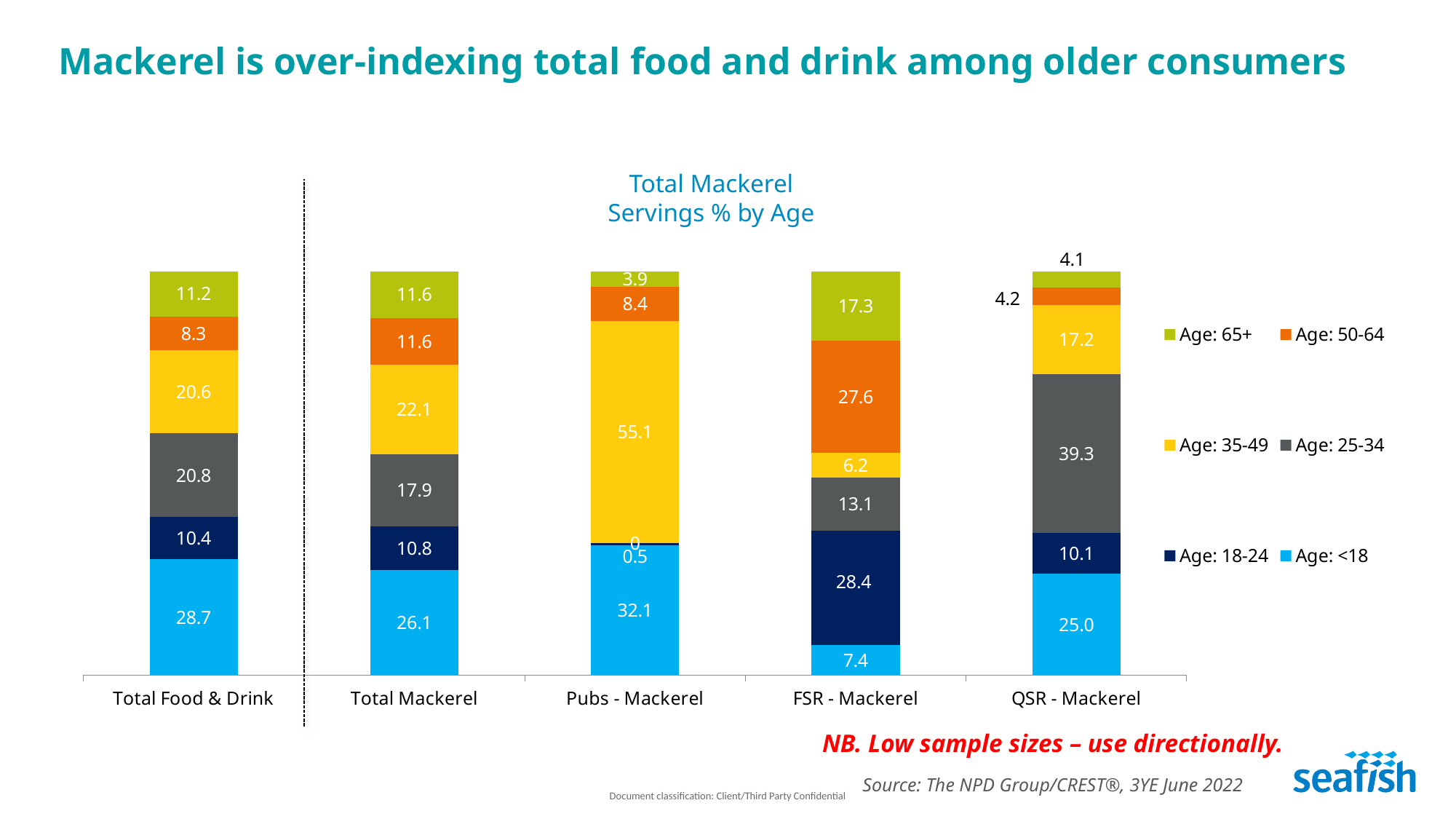
Which has the larger Age: 18-24 value, FSR - Mackerel or QSR - Mackerel? FSR - Mackerel How many series does the legend list? 6 Which category has the largest Age: 35-49 segment? Pubs - Mackerel What is the difference between the Age: 50-64 values for Total Mackerel and Total Food & Drink? 3.3 What is the value for Age: 35-49 in the Pubs - Mackerel bar? 55.1 Which category has the smallest Age: <18 segment? FSR - Mackerel What is the difference between the Age: 65+ values for FSR - Mackerel and Total Food & Drink? 6.1 How many categories are shown on the x axis? 5 What is the value for Age: 25-34 in the QSR - Mackerel bar? 39.3 What kind of chart is shown on the slide? Stacked bar chart What is the value for Age: 65+ in the FSR - Mackerel bar? 17.3 What is the value for Age: <18 in the Total Food & Drink bar? 28.7